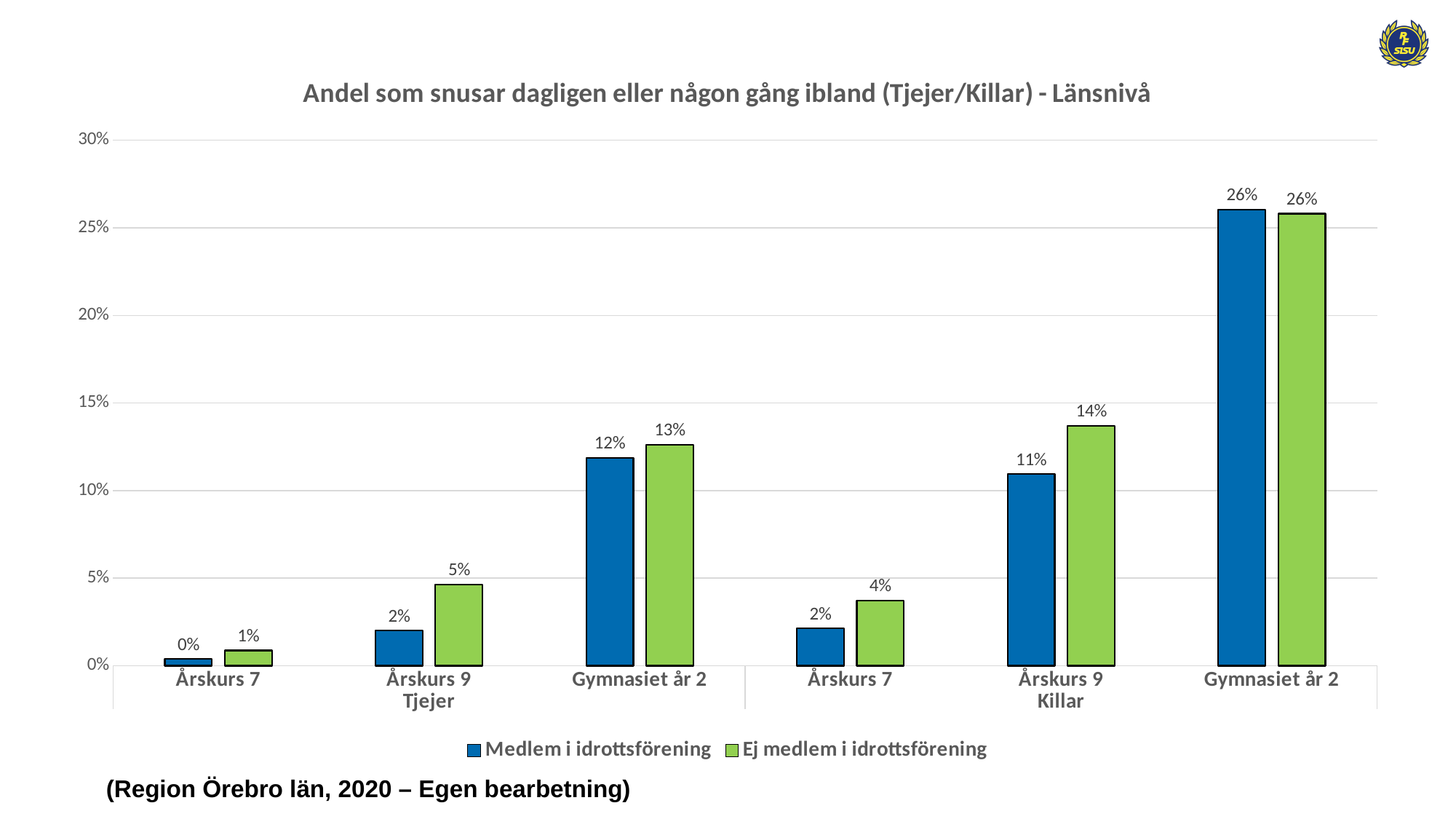
How many series does the legend list? 2 What is the difference between Ej medlem i idrottsförening and Medlem i idrottsförening for Årskurs 9 among Killar? 3% Do the values for Medlem i idrottsförening rise or fall from Årskurs 7 to Gymnasiet år 2 among Killar? Rise Is the value for Medlem i idrottsförening for Gymnasiet år 2 among Killar greater or less than 20%? greater What kind of chart is shown on the slide? Bar chart What is the value for Medlem i idrottsförening for Årskurs 9 among Killar? 11% What is the value for Medlem i idrottsförening for Gymnasiet år 2 among Tjejer? 12% What is the value for Ej medlem i idrottsförening for Årskurs 7 among Tjejer? 1% Which category has the lowest value for Medlem i idrottsförening? Årskurs 7 (Tjejer) What is the difference between Ej medlem i idrottsförening and Medlem i idrottsförening for Årskurs 9 among Tjejer? 3% For Årskurs 7 among Killar, which is larger: Medlem i idrottsförening or Ej medlem i idrottsförening? Ej medlem i idrottsförening What is the value for Ej medlem i idrottsförening for Årskurs 9 among Killar? 14%